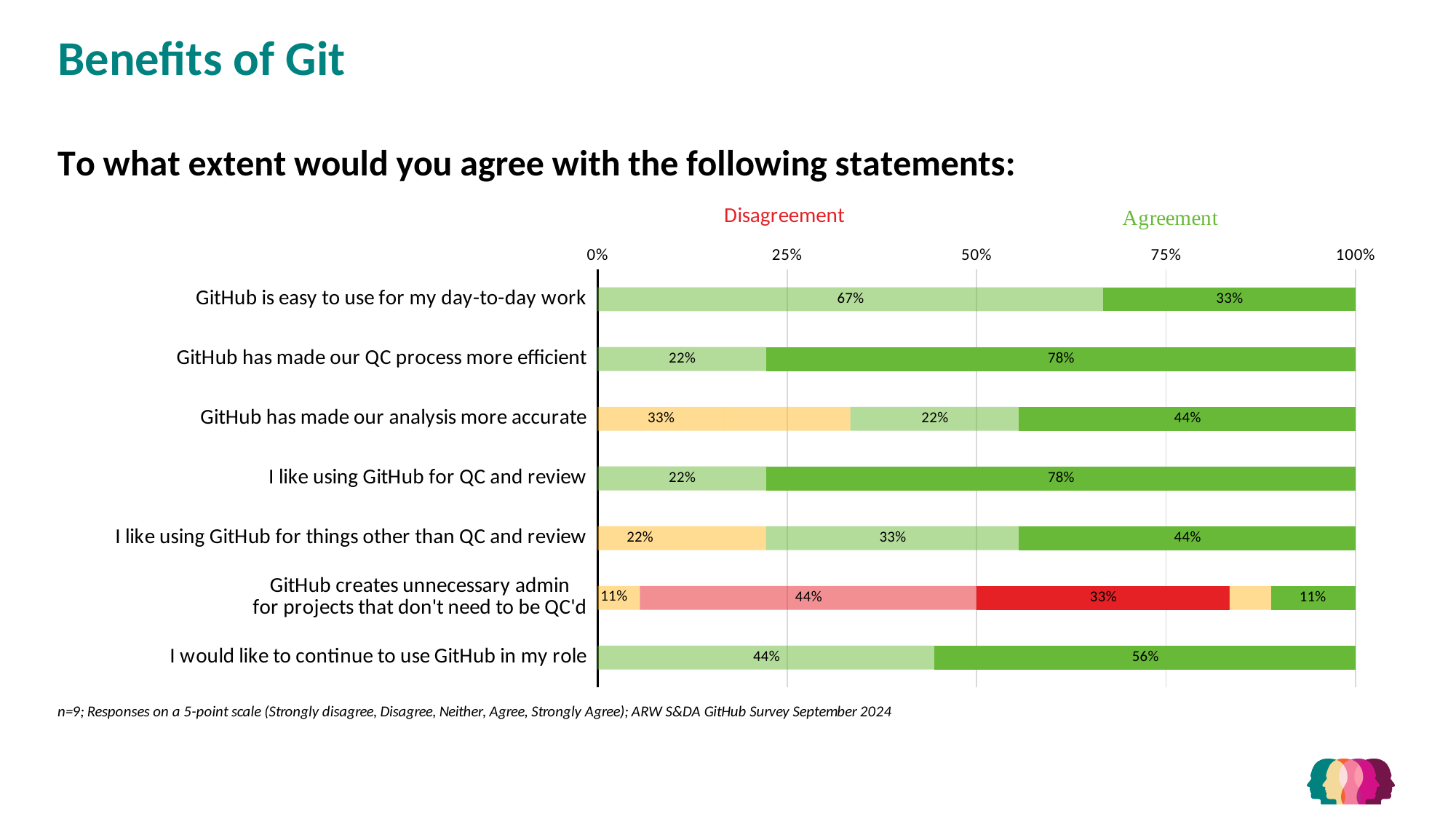
Which statement has the largest light green segment? GitHub is easy to use for my day-to-day work What percentage is shown in the yellow segment for "GitHub has made our analysis more accurate"? 33% What percentage is shown in the dark green segment for "I would like to continue to use GitHub in my role"? 56% Which has a larger dark green segment: "I like using GitHub for QC and review" or "I like using GitHub for things other than QC and review"? I like using GitHub for QC and review For "GitHub has made our QC process more efficient", how many percentage points larger is the dark green segment than the light green segment? 56 percentage points What two labels appear above the chart indicating the direction of responses? Disagreement and Agreement What percentage is shown in the bright red segment for "GitHub creates unnecessary admin for projects that don't need to be QC'd"? 33% How many statements are plotted in the chart? 7 What percentage is shown in the dark green segment for "GitHub has made our QC process more efficient"? 78% What percentage is shown in the light green segment for "GitHub is easy to use for my day-to-day work"? 67% What kind of chart is shown on the slide? Stacked bar chart For "GitHub is easy to use for my day-to-day work", what is the difference between the light green segment (67%) and the dark green segment (33%)? 34 percentage points